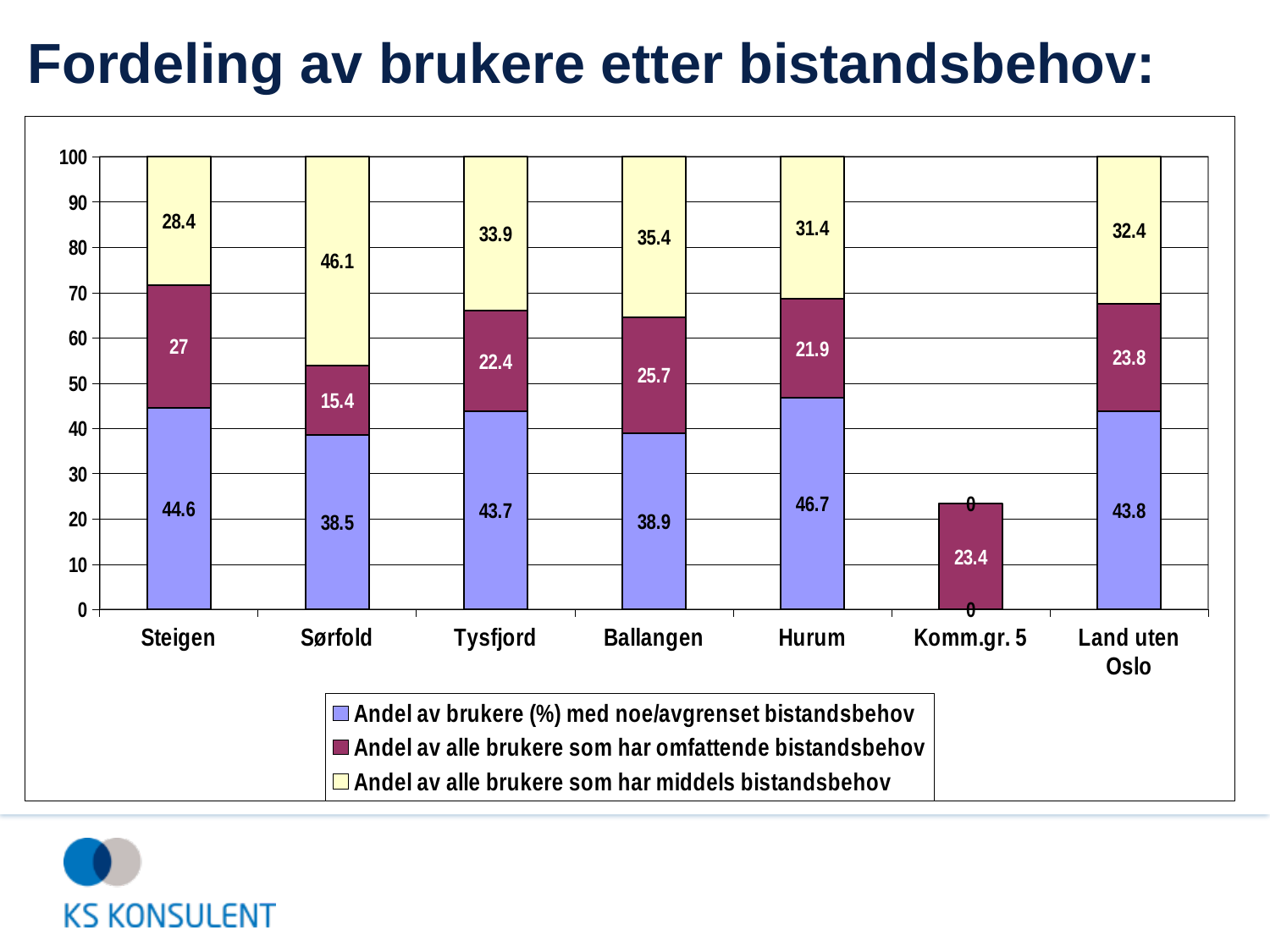
Which category has the highest value for 'Andel av brukere (%) med noe/avgrenset bistandsbehov'? Hurum How many categories are shown on the x axis? 7 What colour represents 'Andel av alle brukere som har middels bistandsbehov' in the chart? Yellow What is the total height of the stacked bar for Komm.gr. 5? 23.4 What is the value of 'Andel av brukere (%) med noe/avgrenset bistandsbehov' for Steigen? 44.6 Which category has the lowest value for 'Andel av alle brukere som har omfattende bistandsbehov'? Sørfold What is the value of 'Andel av alle brukere som har middels bistandsbehov' for Sørfold? 46.1 What is the value of 'Andel av alle brukere som har omfattende bistandsbehov' for Komm.gr. 5? 23.4 What is the difference between the 'middels bistandsbehov' values for Sørfold and Steigen? 17.7 What kind of chart is shown on the slide? Stacked bar chart How many series does the legend list? 3 Which has the larger 'omfattende bistandsbehov' value, Ballangen or Tysfjord? Ballangen